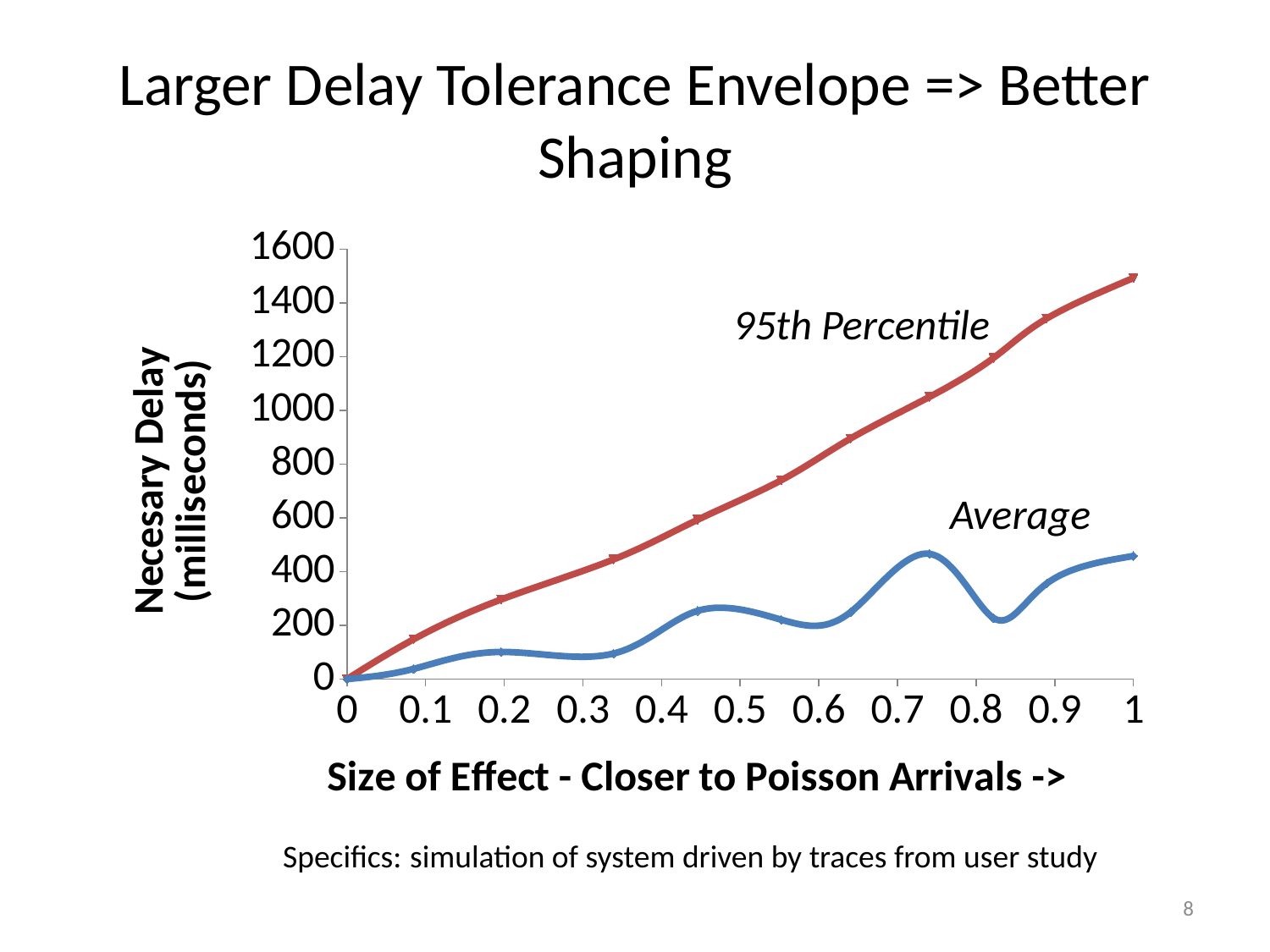
Does the 95th Percentile series rise or fall as the size of effect increases from 0 to 1? rise Is the value for Average at a size of effect of 1 greater or less than 600? less What kind of chart is shown on the slide? line chart Which series reaches the highest necessary delay on the chart? 95th Percentile What is the value of the 95th Percentile series at a size of effect of 0? 0 How many data series are plotted on the chart? 2 At a size of effect of 1, which series has the higher value, 95th Percentile or Average? 95th Percentile Is the value for 95th Percentile at a size of effect of 0.5 greater or less than 800? less What is the title of the x axis? Size of Effect - Closer to Poisson Arrivals -> Is the value for Average at a size of effect of 0.8 greater or less than 400? less What is the title of the y axis? Necesary Delay (milliseconds)